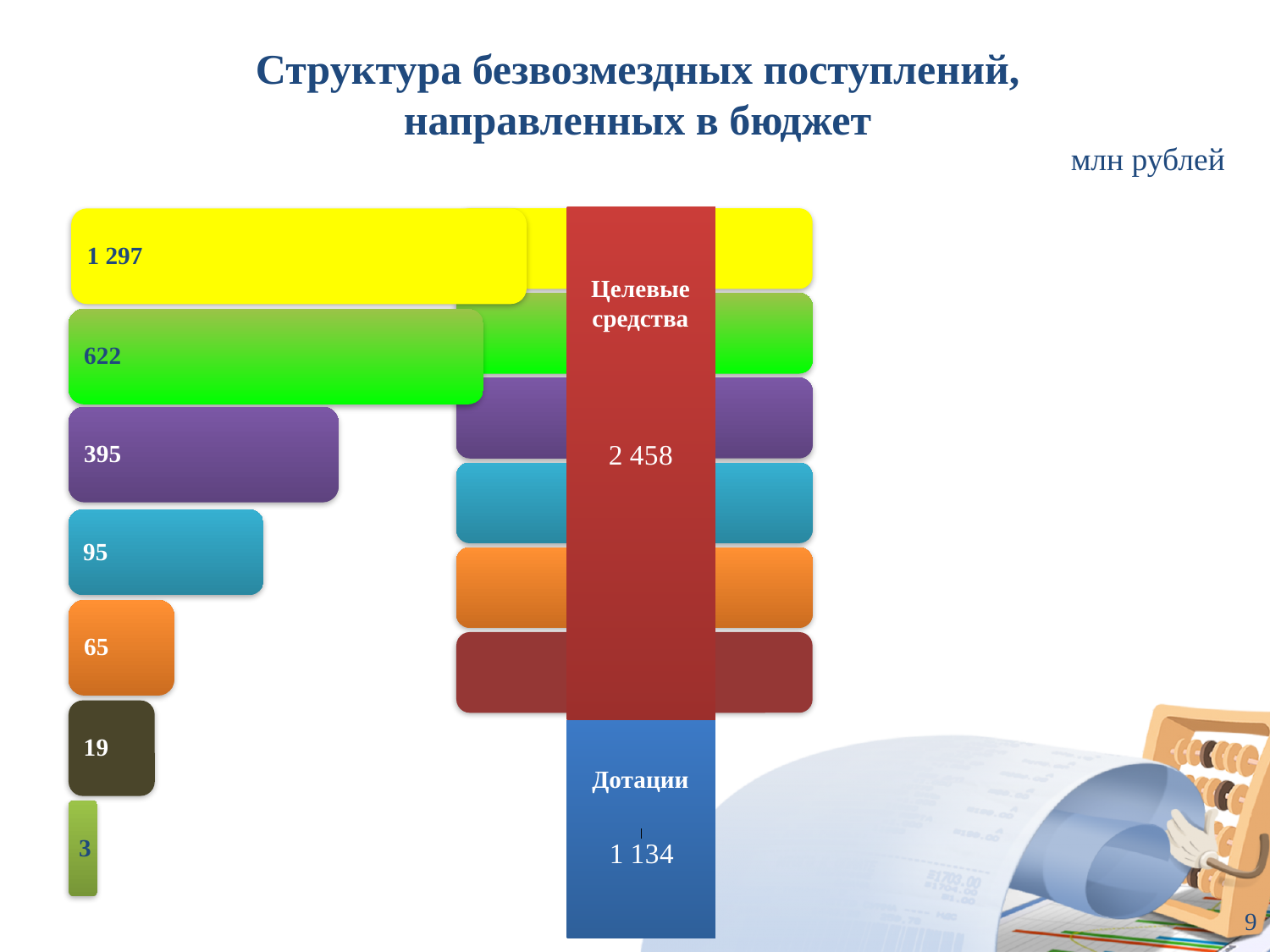
How many horizontal bars are shown on the left side of the slide? 7 What is the total of the stacked column combining Целевые средства and Дотации? 3 592 In what units are the values on the slide expressed? млн рублей Which is larger, Целевые средства or Дотации? Целевые средства What is the value shown for Дотации in the stacked column? 1 134 What is the smallest value among the horizontal bars on the left? 3 What is the difference between Целевые средства (2 458) and Дотации (1 134)? 1 324 What is the value shown for Целевые средства in the stacked column? 2 458 What is the largest value among the horizontal bars on the left? 1 297 What kind of chart is shown on the slide? bar chart What is the difference between the two largest horizontal bars (1 297 and 622)? 675 Do the values of the horizontal bars increase or decrease from top to bottom? decrease